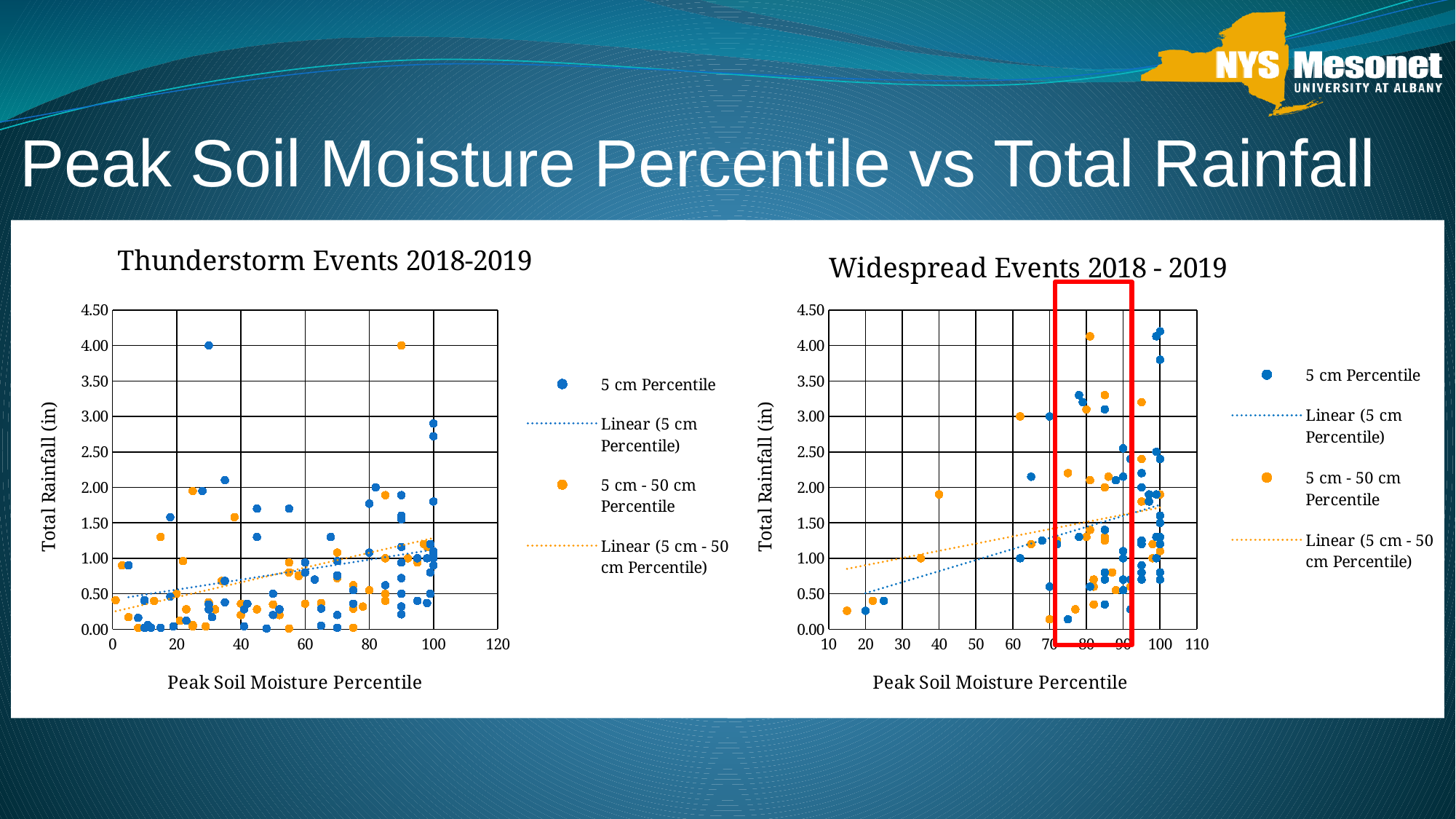
In the Widespread Events 2018 - 2019 chart, is the highest Total Rainfall value plotted greater or less than 4.00? greater In the Widespread Events 2018 - 2019 chart, is the 5 cm - 50 cm Percentile point at a Peak Soil Moisture Percentile of 40 greater or less than 1.50 in Total Rainfall? greater What is the y-axis title of the Widespread Events 2018 - 2019 chart? Total Rainfall (in) In the Widespread Events 2018 - 2019 chart, do the linear trend lines rise or fall as Peak Soil Moisture Percentile increases? Rise What is the maximum x-axis tick value shown on the Widespread Events 2018 - 2019 chart? 110 What is the top y-axis tick value on the Thunderstorm Events 2018-2019 chart? 4.50 How many entries does the legend of the Widespread Events 2018 - 2019 chart list? 4 What kind of chart is the Thunderstorm Events 2018-2019 chart? Scatter chart What is the maximum x-axis tick value shown on the Thunderstorm Events 2018-2019 chart? 120 In the Thunderstorm Events 2018-2019 chart, do the linear trend lines rise or fall as Peak Soil Moisture Percentile increases? Rise In the Thunderstorm Events 2018-2019 chart, is the 5 cm - 50 cm Percentile point near a Peak Soil Moisture Percentile of 15 greater or less than 1.00 in Total Rainfall? greater In the Thunderstorm Events 2018-2019 chart, what are the two plotted data series named in the legend? 5 cm Percentile and 5 cm - 50 cm Percentile